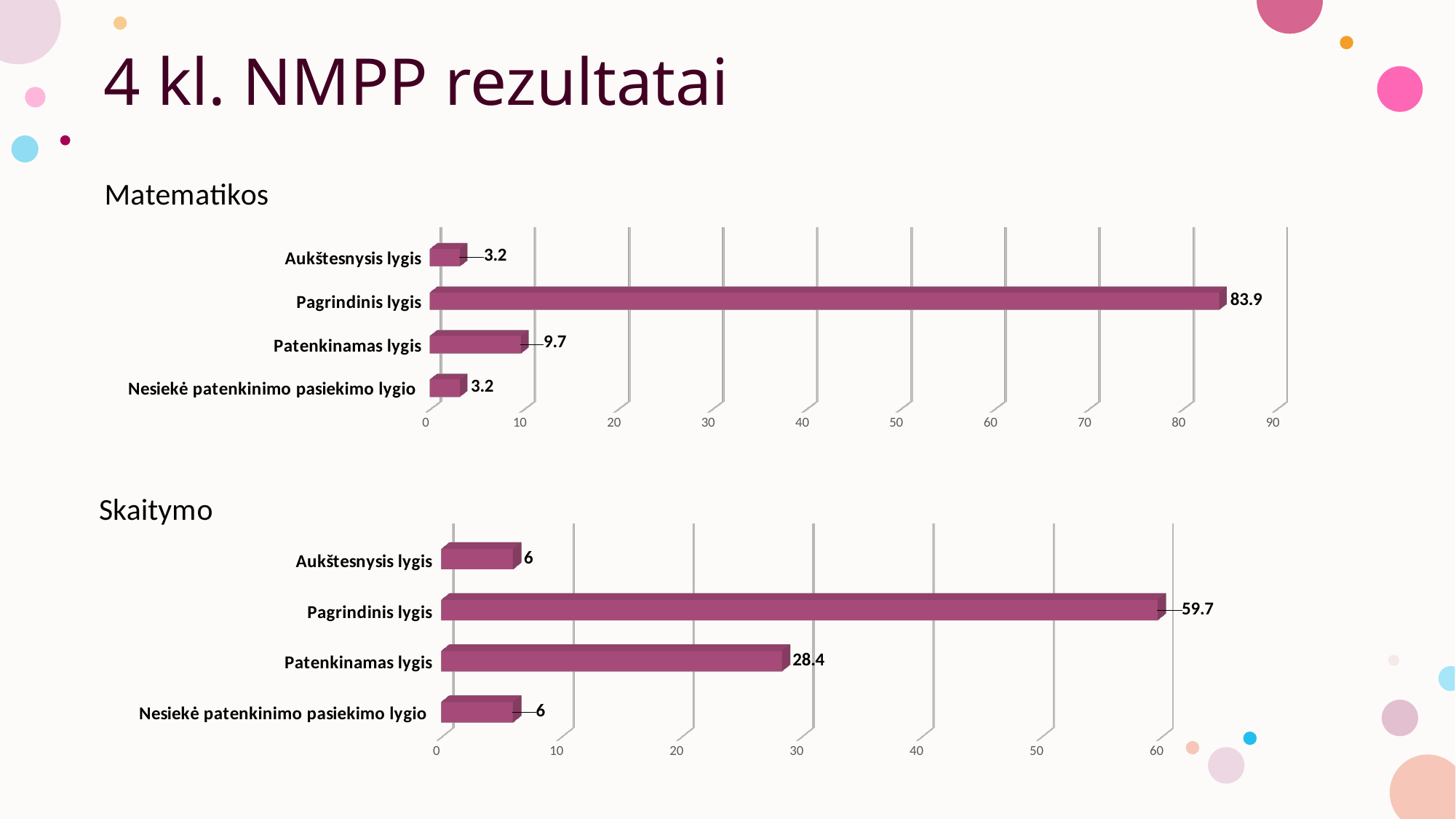
What kind of chart is the Skaitymo chart? Bar chart How many categories does the Matematikos chart show? 4 In the Skaitymo chart, which is larger: Patenkinamas lygis or Aukštesnysis lygis? Patenkinamas lygis In the Skaitymo chart, which category has the highest value? Pagrindinis lygis In the Matematikos chart, what is the difference between Pagrindinis lygis and Patenkinamas lygis? 74.2 In the Skaitymo chart, what is the difference between Pagrindinis lygis and Patenkinamas lygis? 31.3 In the Skaitymo chart, what is the value for Patenkinamas lygis? 28.4 In the Skaitymo chart, is the value for Pagrindinis lygis greater or less than 50? greater In the Matematikos chart, what is the value for Pagrindinis lygis? 83.9 In the Matematikos chart, what is the value for Patenkinamas lygis? 9.7 In the Skaitymo chart, what is the value for Pagrindinis lygis? 59.7 In the Matematikos chart, which category has the highest value? Pagrindinis lygis